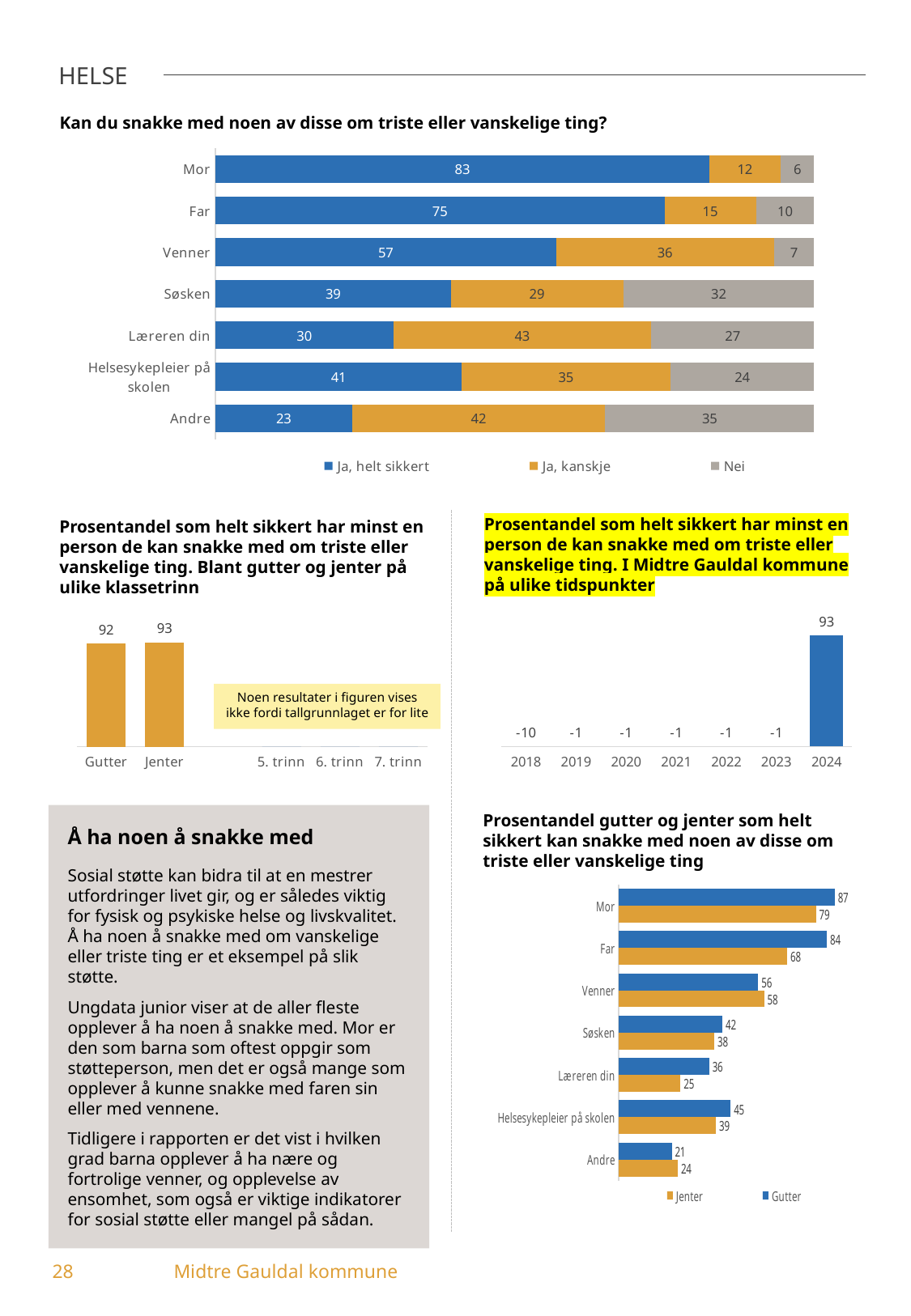
In the chart 'Prosentandel gutter og jenter som helt sikkert kan snakke med noen av disse om triste eller vanskelige ting', which is larger for Venner: Gutter or Jenter? Jenter In the chart 'Kan du snakke med noen av disse om triste eller vanskelige ting?', which category has the highest 'Ja, helt sikkert' value? Mor How many series does the legend list in the chart 'Kan du snakke med noen av disse om triste eller vanskelige ting?'? 3 What kind of chart is 'Prosentandel gutter og jenter som helt sikkert kan snakke med noen av disse om triste eller vanskelige ting'? Bar chart In the chart 'Kan du snakke med noen av disse om triste eller vanskelige ting?', what is the difference between the 'Ja, kanskje' values for Læreren din and Mor? 31 How many categories are shown in the chart 'Kan du snakke med noen av disse om triste eller vanskelige ting?'? 7 In the chart 'Prosentandel gutter og jenter som helt sikkert kan snakke med noen av disse om triste eller vanskelige ting', what is the value for Gutter for Far? 84 In the chart 'Kan du snakke med noen av disse om triste eller vanskelige ting?', what is the value of 'Ja, helt sikkert' for Mor? 83 In the chart 'Prosentandel som helt sikkert har minst en person de kan snakke med om triste eller vanskelige ting. Blant gutter og jenter på ulike klassetrinn', what is the value for Jenter? 93 In the chart 'Kan du snakke med noen av disse om triste eller vanskelige ting?', which category has the lowest 'Ja, helt sikkert' value? Andre In the chart 'Prosentandel som helt sikkert har minst en person de kan snakke med om triste eller vanskelige ting. I Midtre Gauldal kommune på ulike tidspunkter', what is the value for 2024? 93 In the chart 'Kan du snakke med noen av disse om triste eller vanskelige ting?', what is the value of 'Nei' for Søsken? 32